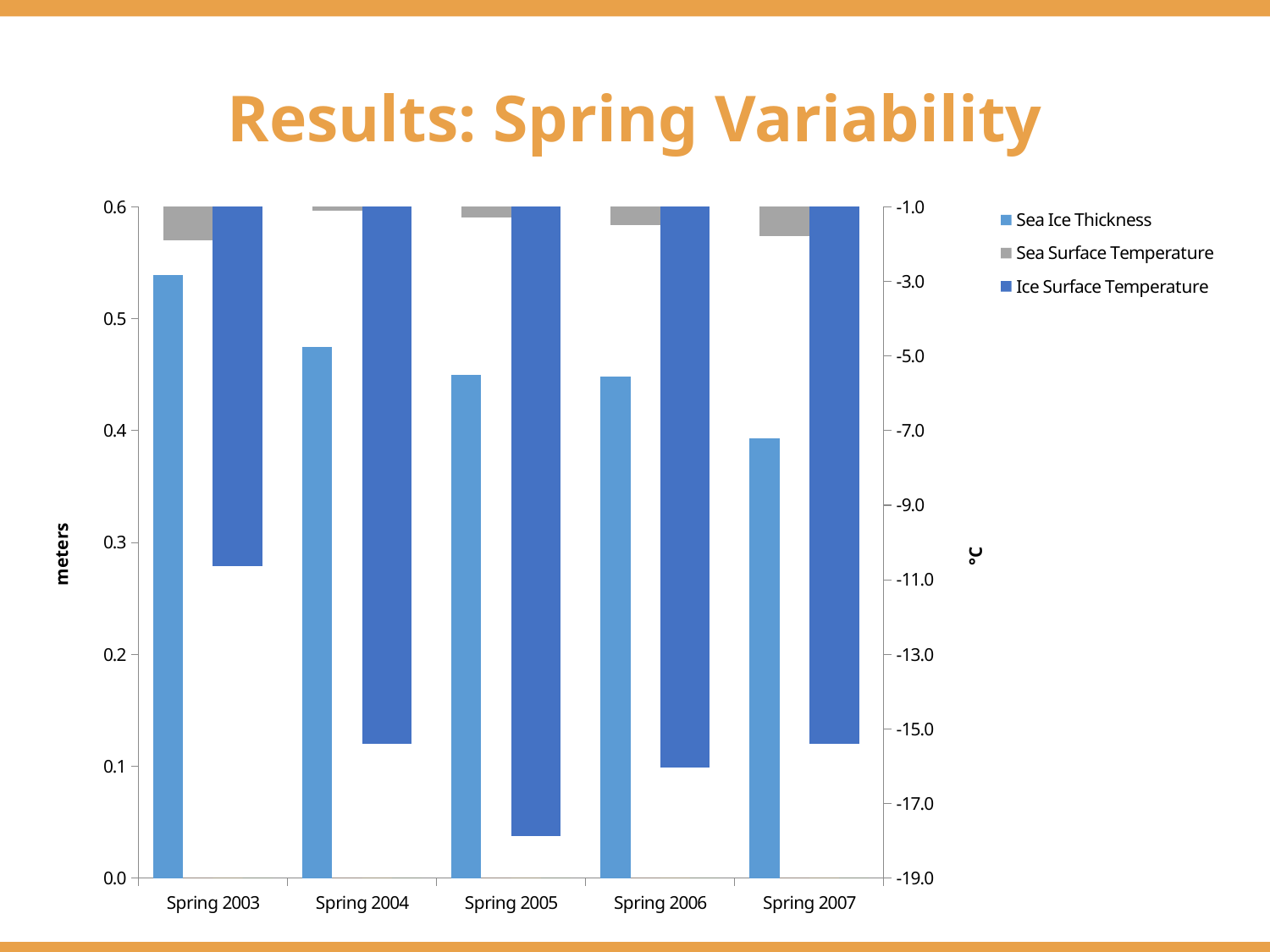
Which category has the lowest Sea Ice Thickness? Spring 2007 Which category has the highest Ice Surface Temperature? Spring 2003 Does Sea Ice Thickness rise or fall from Spring 2003 to Spring 2007? fall Is the Ice Surface Temperature for Spring 2005 greater or less than -17.0 °C? less How many series does the legend list? 3 Is the Sea Ice Thickness for Spring 2003 greater or less than 0.5 meters? greater Which category has the highest Sea Ice Thickness? Spring 2003 Which category has the lowest Ice Surface Temperature? Spring 2005 What is the label of the left vertical axis? meters What kind of chart is shown on the slide? Bar chart How many categories are shown on the x axis? 5